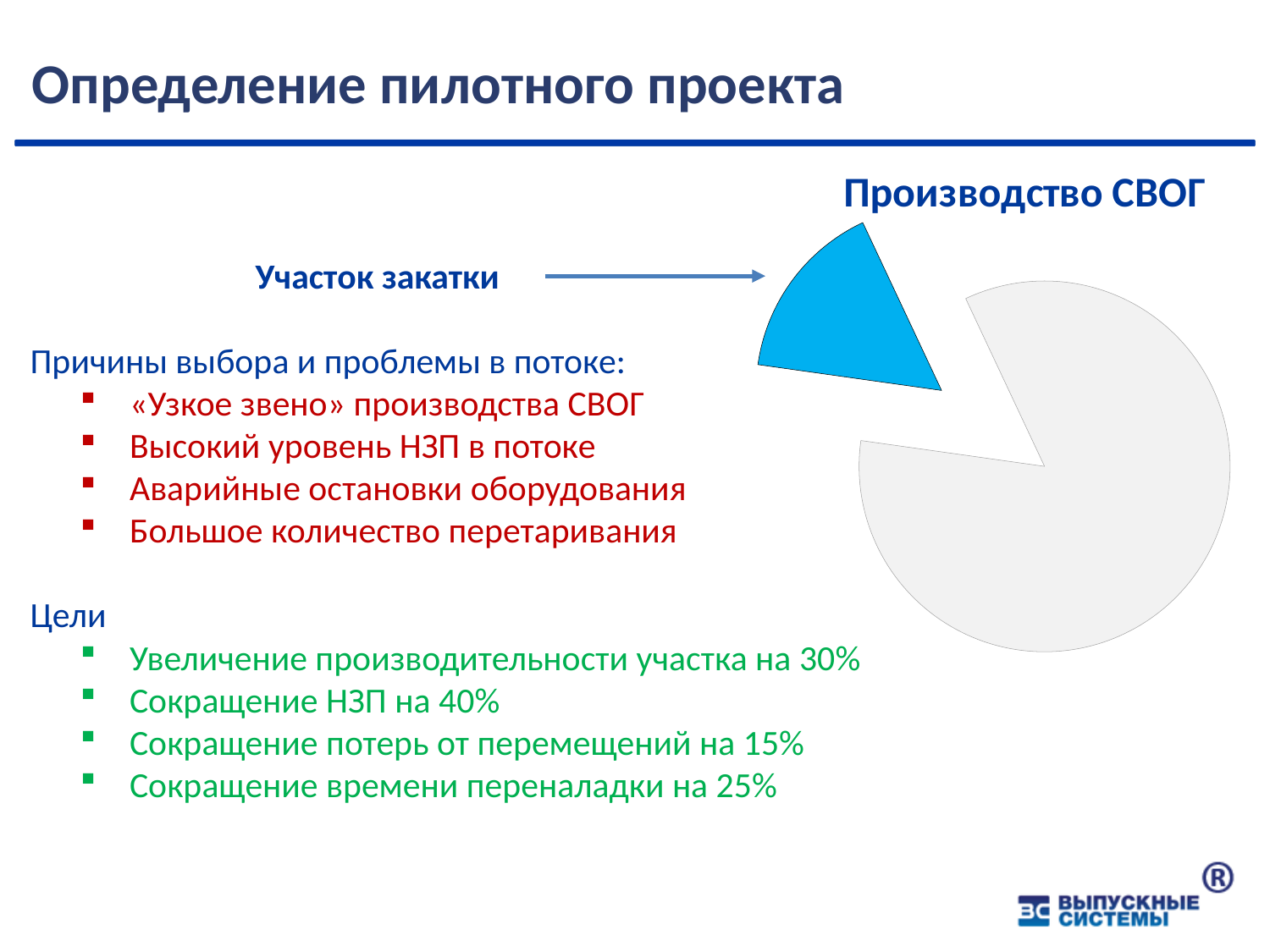
Is the Участок закатки slice greater or less than half of the pie? less How many slices does the pie chart have? 2 Is the Участок закатки slice the larger or the smaller slice of the pie chart? smaller What kind of chart is shown on the slide? pie chart What is the title of the pie chart? Производство СВОГ Which slice of the pie chart is pulled out (exploded) from the rest? Участок закатки